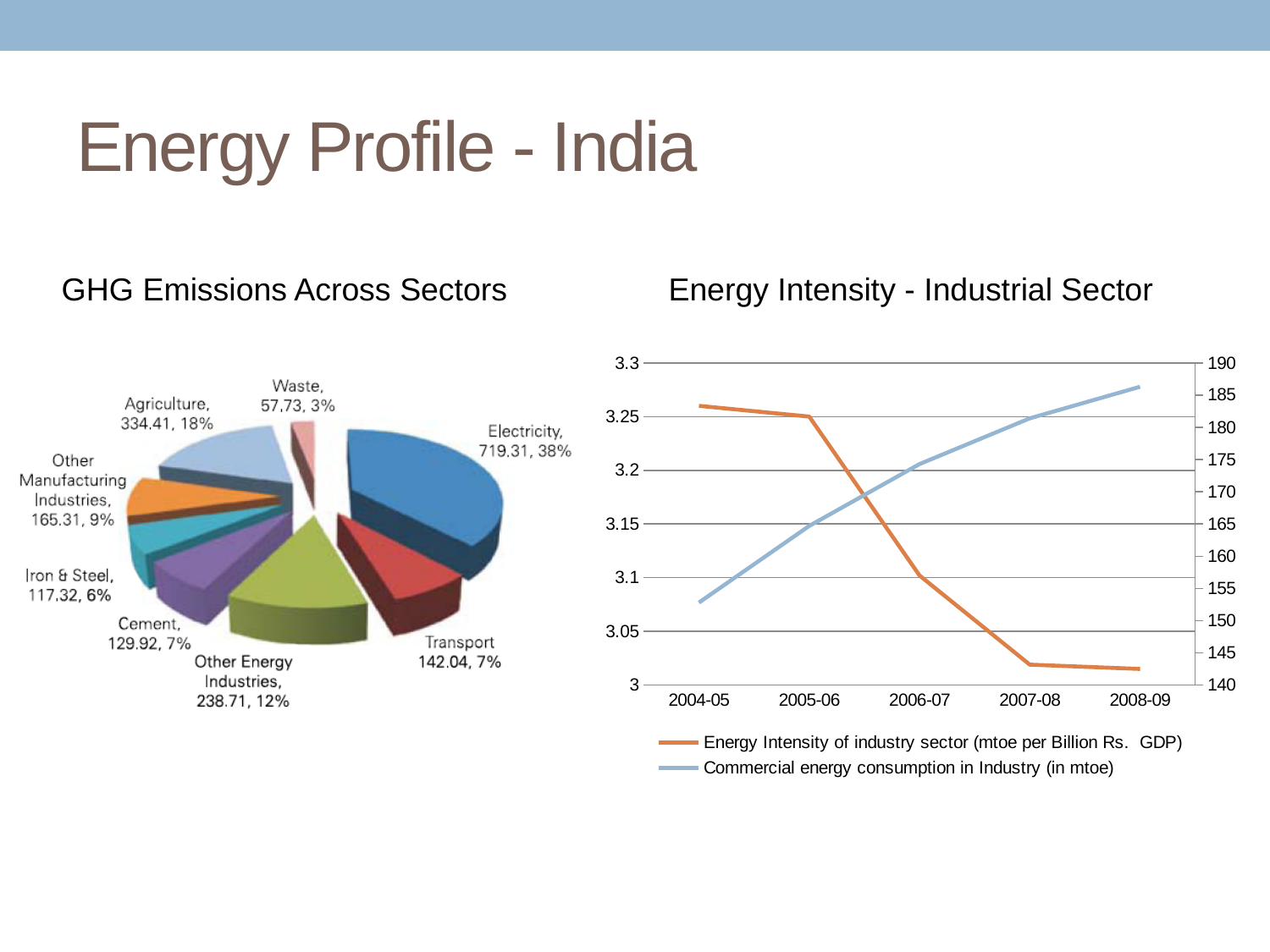
In the Energy Intensity - Industrial Sector chart, does the Energy Intensity of industry sector series rise or fall from 2004-05 to 2008-09? Fall In the GHG Emissions Across Sectors chart, which sector has the smallest share? Waste In the GHG Emissions Across Sectors chart, what value is shown for Electricity? 719.31, 38% In the GHG Emissions Across Sectors chart, which sector has the largest share? Electricity In the GHG Emissions Across Sectors chart, what is the difference between the Cement value and the Iron & Steel value? 12.60 In the Energy Intensity - Industrial Sector chart, is the Commercial energy consumption in Industry value for 2008-09 greater or less than 185? greater In the GHG Emissions Across Sectors chart, what percentage share does Agriculture have? 18% In the Energy Intensity - Industrial Sector chart, is the Energy Intensity of industry sector value for 2008-09 greater or less than 3.05? less In the GHG Emissions Across Sectors chart, which is larger, Other Energy Industries or Other Manufacturing Industries? Other Energy Industries How many series does the legend of the Energy Intensity - Industrial Sector chart list? 2 How many sectors are shown in the GHG Emissions Across Sectors pie chart? 8 What type of chart is the GHG Emissions Across Sectors chart? Pie chart